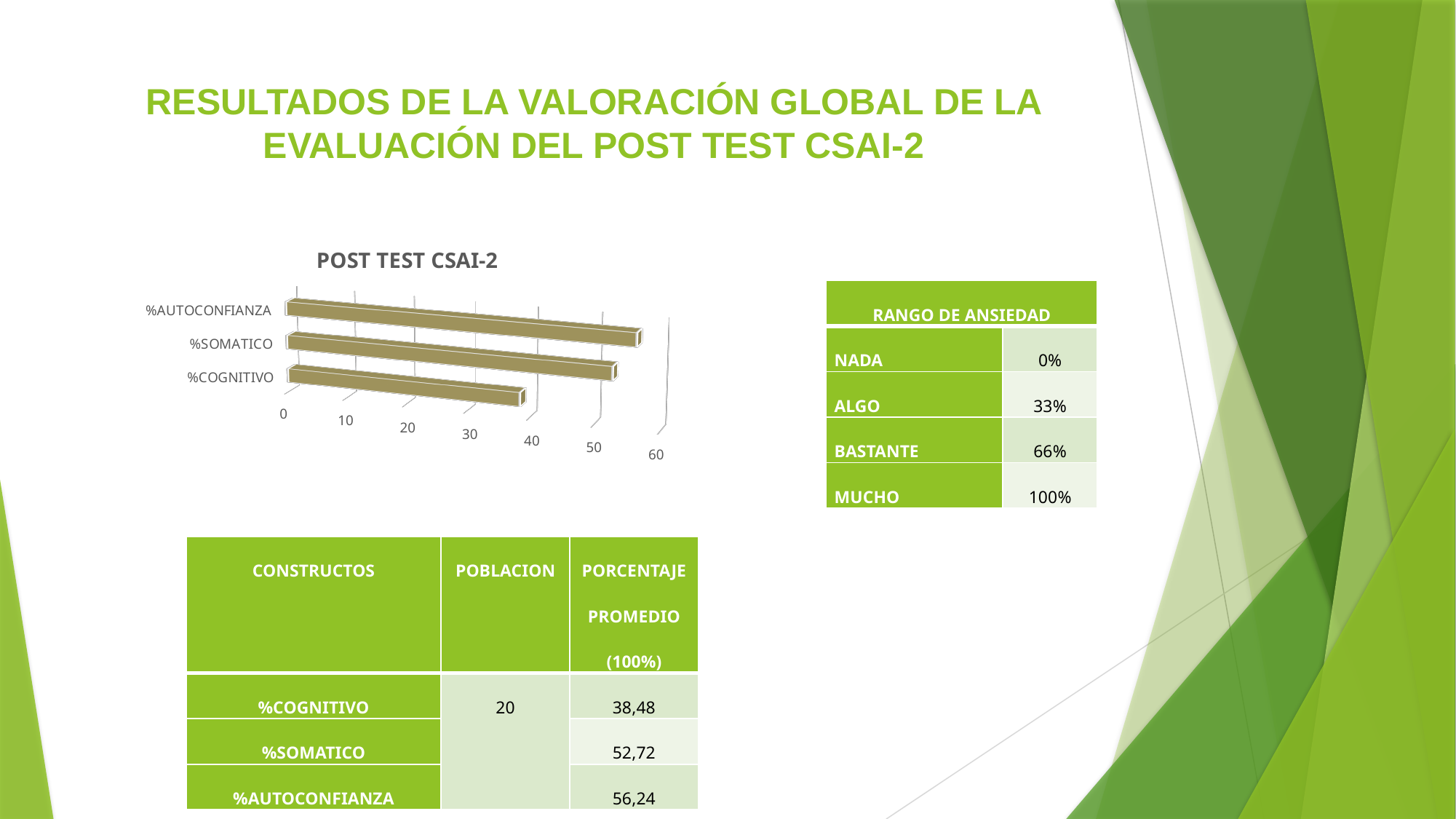
In the POST TEST CSAI-2 chart, which is larger, the value for %AUTOCONFIANZA or the value for %COGNITIVO? %AUTOCONFIANZA What is the title of the bar chart on the slide? POST TEST CSAI-2 In the POST TEST CSAI-2 chart, is the value for %COGNITIVO greater or less than 30? greater In the POST TEST CSAI-2 chart, which is larger, the value for %SOMATICO or the value for %COGNITIVO? %SOMATICO Which category has the longest bar in the POST TEST CSAI-2 chart? %AUTOCONFIANZA How many categories are plotted in the POST TEST CSAI-2 chart? 3 What is the highest tick value shown on the value axis of the POST TEST CSAI-2 chart? 60 In the POST TEST CSAI-2 chart, is the value for %SOMATICO greater or less than 40? greater What type of chart is shown under the title POST TEST CSAI-2? bar chart In the POST TEST CSAI-2 chart, is the value for %AUTOCONFIANZA greater or less than 50? greater Which category has the shortest bar in the POST TEST CSAI-2 chart? %COGNITIVO